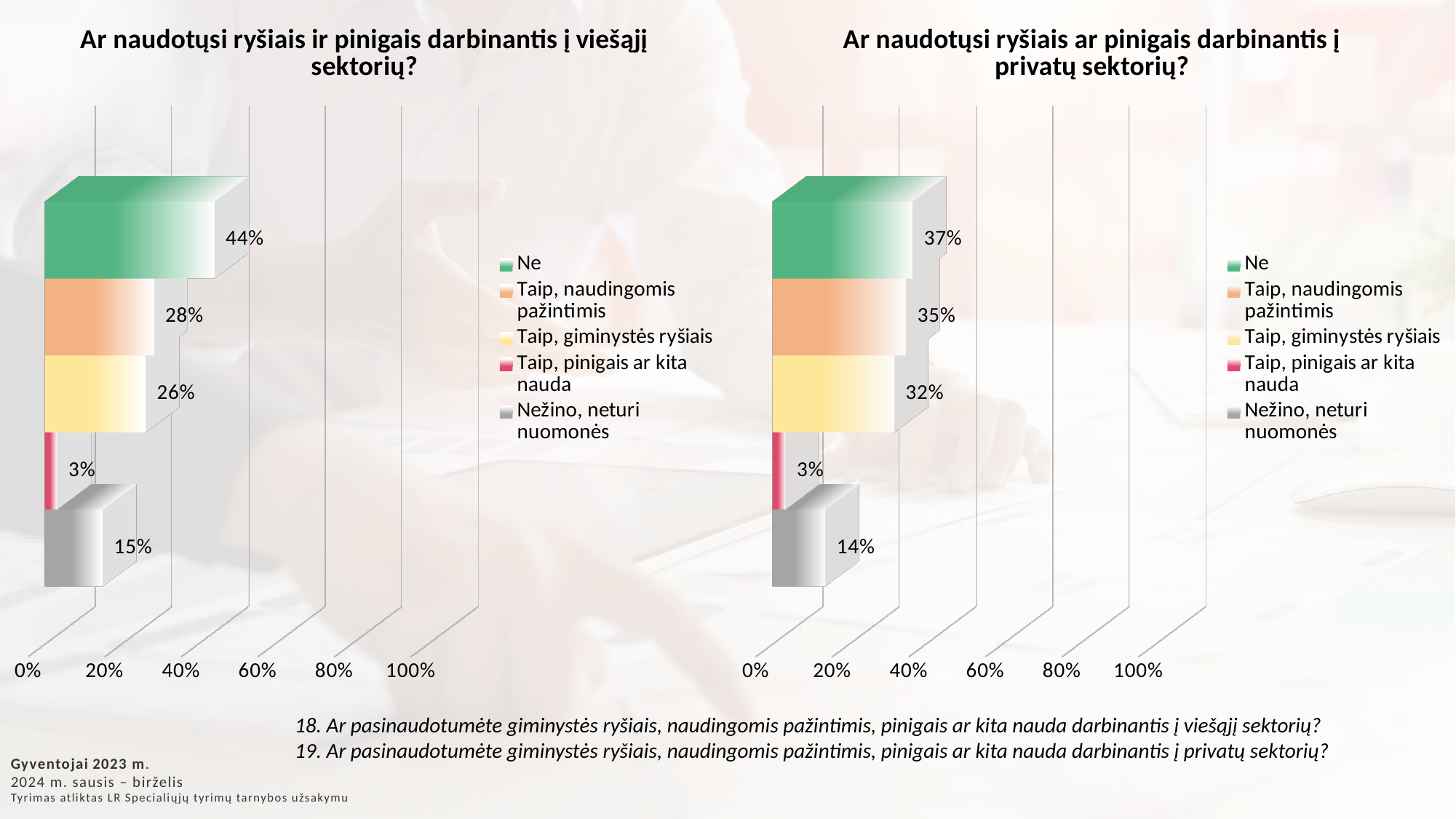
In the left chart (public sector), which category has the highest value? Ne In the left chart (public sector), is the value for "Taip, giminystės ryšiais" greater or less than 20%? greater In the left chart (public sector), what is the difference between "Ne" and "Taip, naudingomis pažintimis"? 16% How many categories are shown in the right chart (private sector)? 5 In the right chart (private sector), which category has the lowest value? Taip, pinigais ar kita nauda In the left chart (public sector), what is the value for "Ne"? 44% Which is larger: "Ne" in the left chart (public sector) or "Ne" in the right chart (private sector)? Left chart (public sector), 44% In the right chart (private sector), what is the value for "Nežino, neturi nuomonės"? 14% How many entries does the legend of the left chart (public sector) list? 5 What type of chart is the left chart (public sector)? Bar chart In the right chart (private sector), what is the value for "Taip, giminystės ryšiais"? 32% In the right chart (private sector), what is the difference between "Taip, naudingomis pažintimis" and "Taip, giminystės ryšiais"? 3%